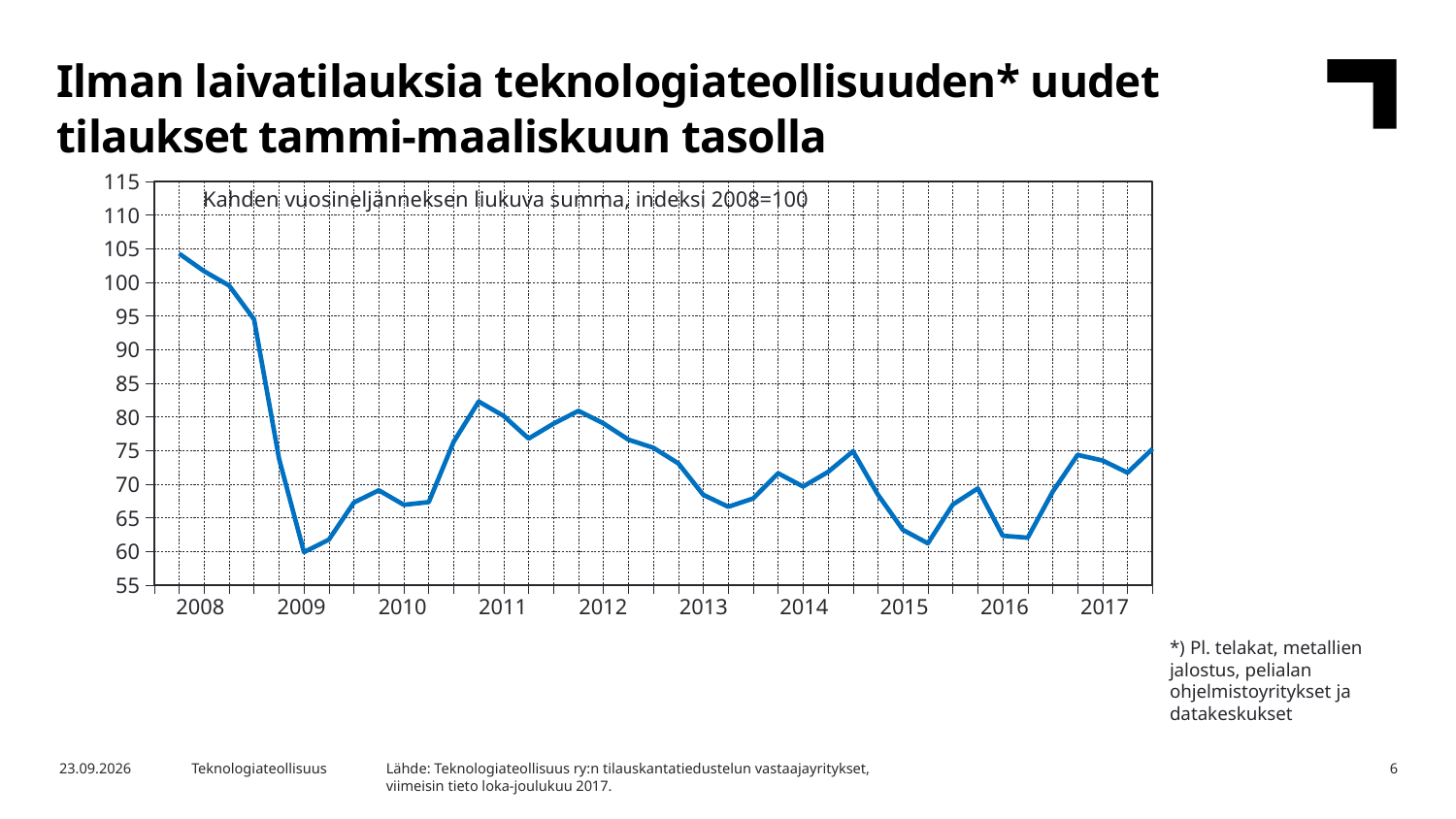
Which year on the x axis has the highest value of the index? 2008 Is the lowest value of the index in 2009 greater or less than 65? less Is the value of the index at the start of 2015 greater or less than 70? less Does the index rise or fall between 2008 and 2009? fall How many years are labelled on the x axis of the chart? 10 Does the index rise or fall between the start of 2016 and the end of 2017? rise Is the value of the index at the start of 2008 greater or less than 100? greater What is the highest value shown on the y axis of the chart? 115 What kind of chart is shown on the slide? line chart In which year does the index reach its lowest point? 2009 What is the subtitle printed inside the chart area? Kahden vuosineljänneksen liukuva summa, indeksi 2008=100